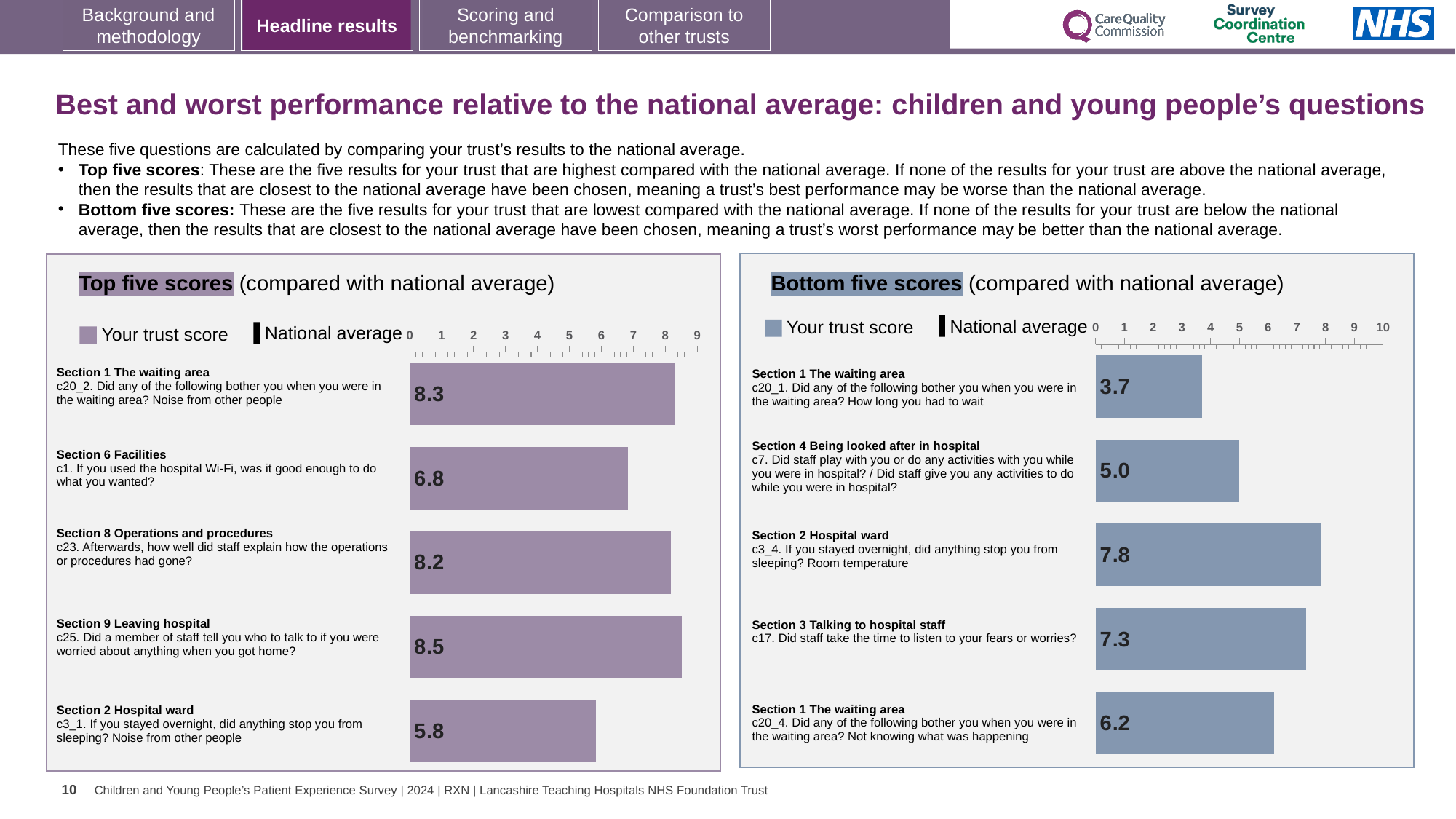
How many questions are plotted in the Bottom five scores chart? 5 In the Top five scores chart, which question has the lowest trust score? c3_1. If you stayed overnight, did anything stop you from sleeping? Noise from other people In the Bottom five scores chart, which question has the lowest trust score? c20_1. Did any of the following bother you when you were in the waiting area? How long you had to wait In the Top five scores chart, which question has the highest trust score? c25. Did a member of staff tell you who to talk to if you were worried about anything when you got home? In the Top five scores chart, what is the difference between the trust scores for c20_2 (8.3) and c3_1 (5.8)? 2.5 In the Bottom five scores chart, which question has the highest trust score? c3_4. If you stayed overnight, did anything stop you from sleeping? Room temperature What type of chart is the Top five scores chart? Bar chart In the Bottom five scores chart, which has the larger trust score: c7 (Did staff play with you or do any activities with you) or c20_4 (Not knowing what was happening)? c20_4 (Not knowing what was happening) In the Bottom five scores chart, what is the trust score for c17 (Did staff take the time to listen to your fears or worries?)? 7.3 In the Top five scores chart, what is the trust score for c25 (Did a member of staff tell you who to talk to if you were worried about anything when you got home?)? 8.5 In the Bottom five scores chart, what is the trust score for c20_1 (How long you had to wait)? 3.7 In the Top five scores chart, what is the trust score for c1 (If you used the hospital Wi-Fi, was it good enough to do what you wanted?)? 6.8